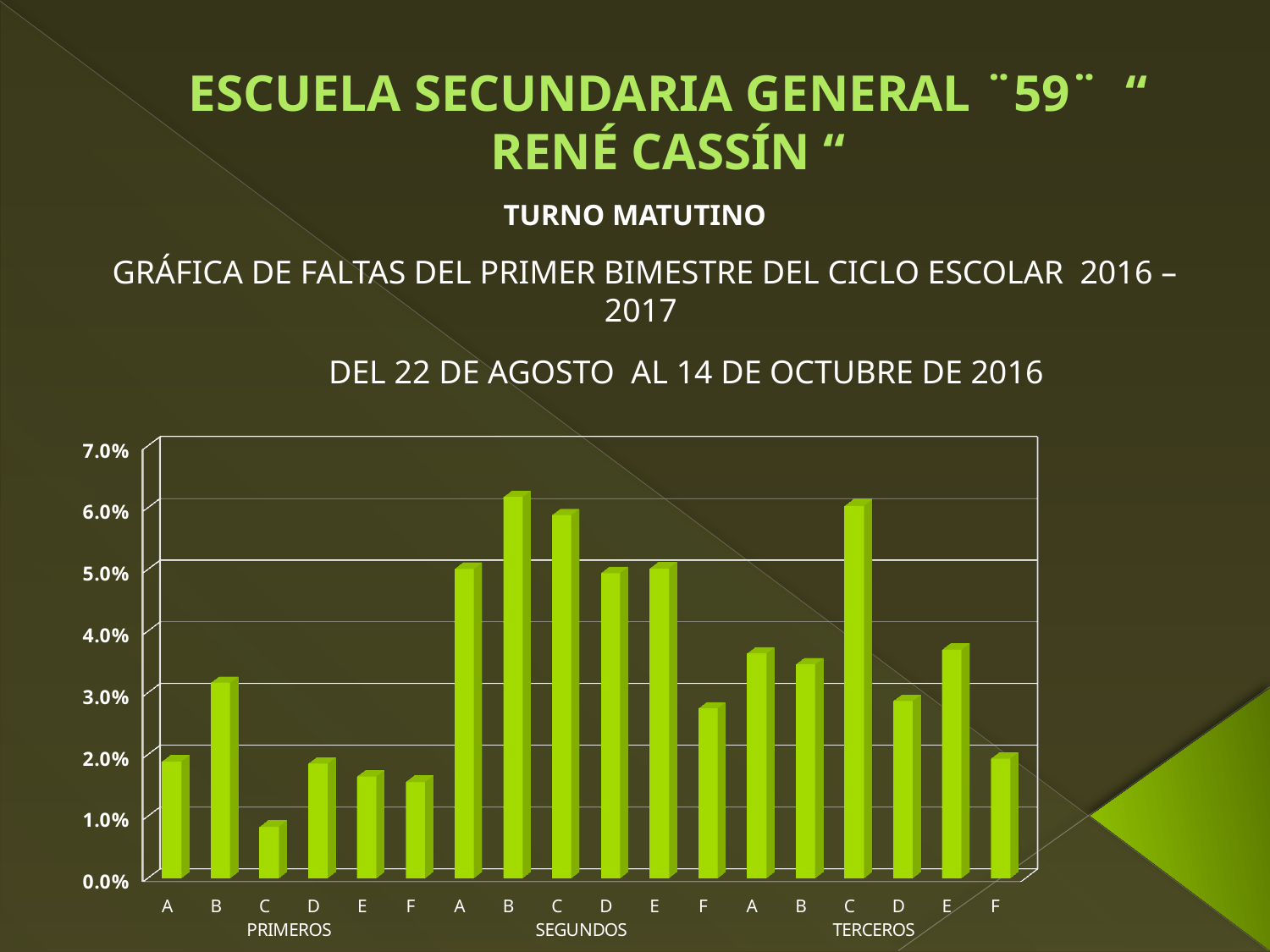
Is the value for TERCEROS A greater or less than 3.0%? greater Which is larger, the value for TERCEROS C or the value for TERCEROS D? TERCEROS C Which is larger, the value for SEGUNDOS A or the value for PRIMEROS A? SEGUNDOS A Which bar is the lowest in the chart? PRIMEROS C How many grade groups are labelled along the x axis of the chart? 3 What is the highest value shown on the y axis of the chart? 7.0% How many bars are plotted in the chart? 18 Is the value for PRIMEROS C greater or less than 1.0%? less Is the value for SEGUNDOS B greater or less than 6.0%? greater What kind of chart is shown on the slide? bar chart